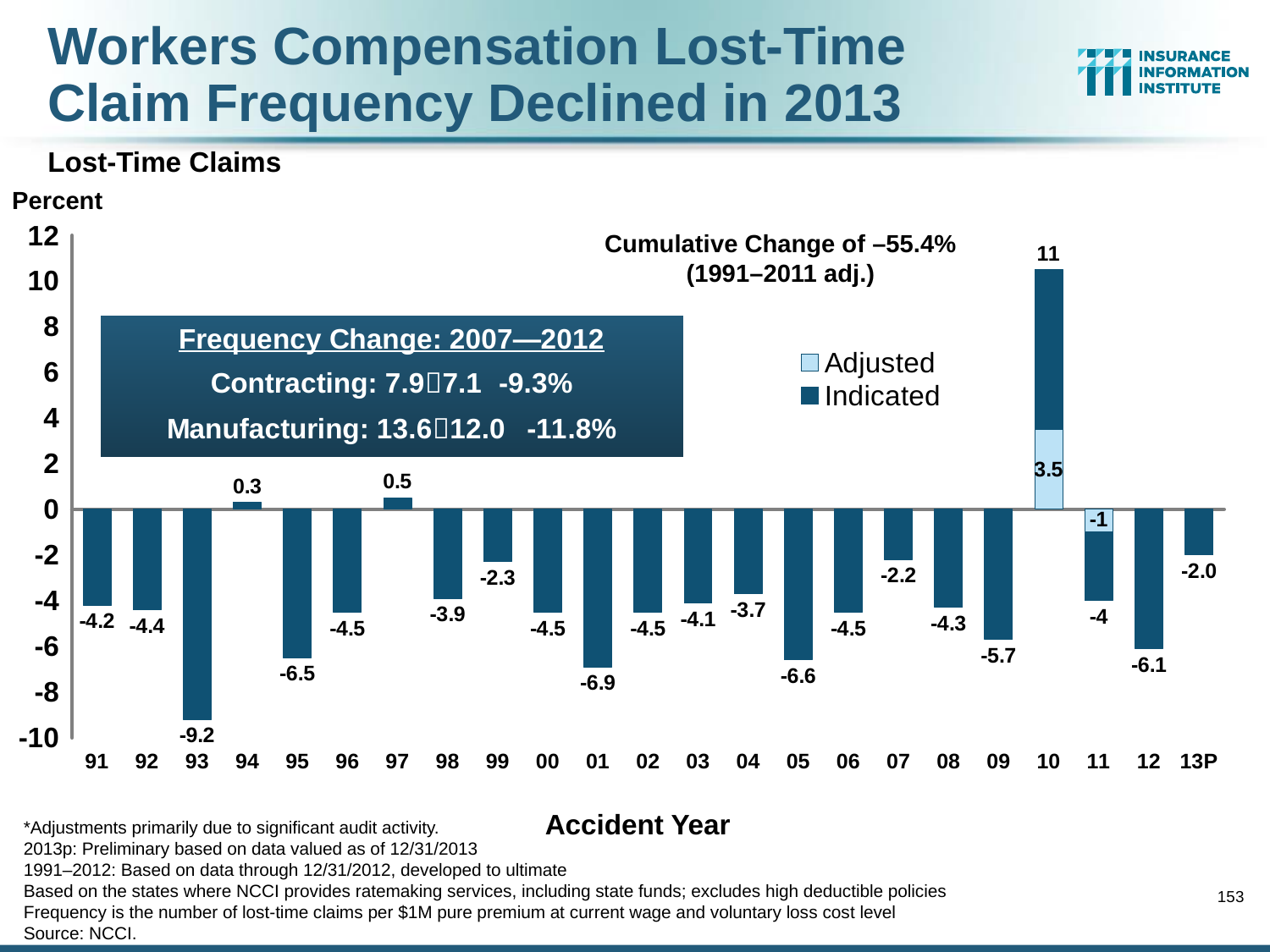
What is the Adjusted value for accident year 10? 3.5 What is the value for accident year 93? -9.2 How many series does the legend list? 2 Which accident year has the lowest value? 93 How many accident years are shown on the x axis? 23 Which accident year has the highest value? 10 Which is larger, the value for 01 or the value for 05? 05 What cumulative change (1991–2011 adj.) is stated on the chart? –55.4% What is the value for accident year 97? 0.5 What is the value for 13P? -2.0 What kind of chart is this? Bar chart What is the difference between the values for 12 and 13P? 4.1